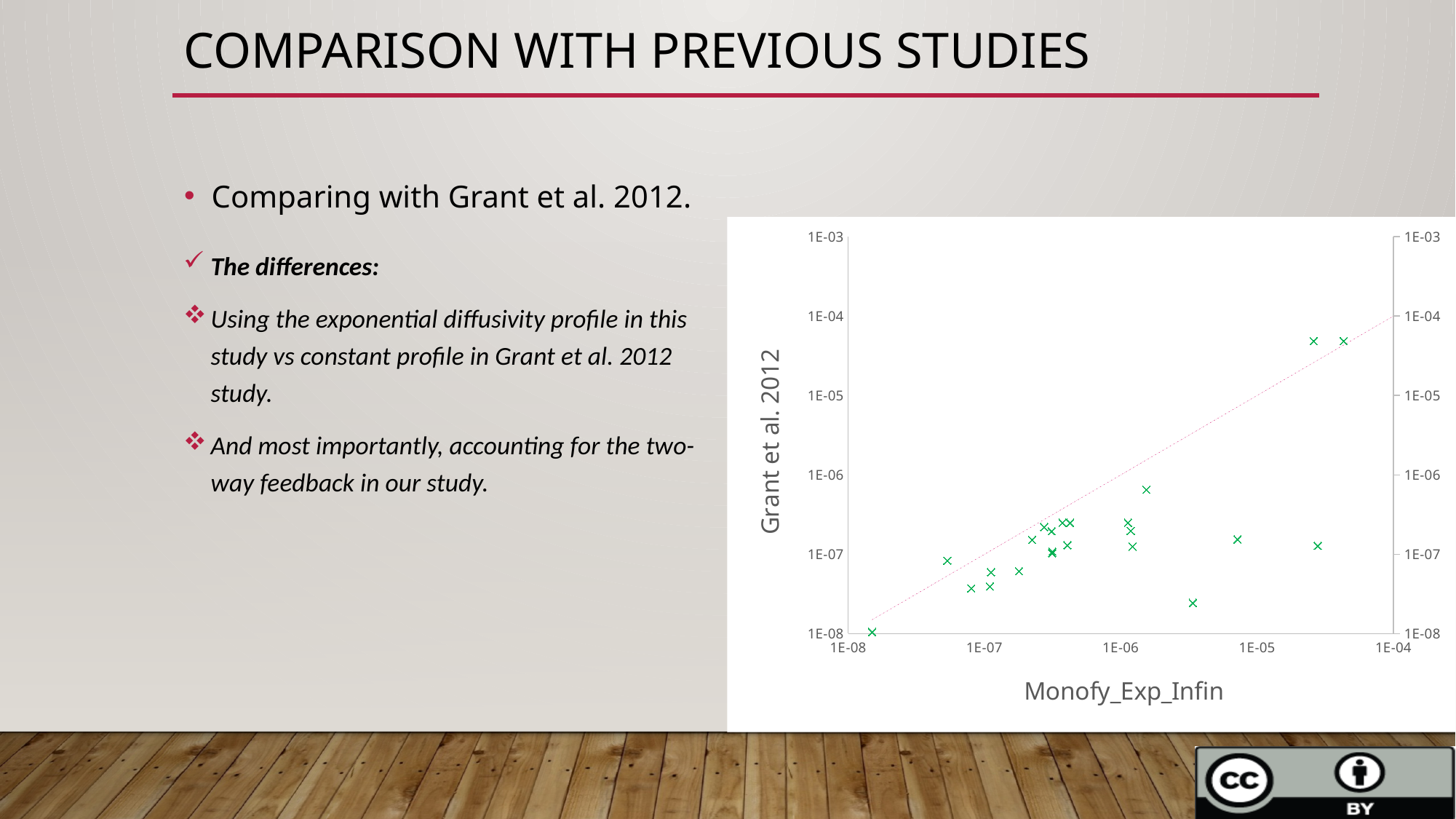
Is the highest plotted y value in the chart greater or less than 1E-05? greater Is the highest plotted y value in the chart greater or less than 1E-04? less What is the lowest tick label shown on the x axis of the chart? 1E-08 Are any points in the chart plotted above 1E-03 on the y axis? No What is the title of the x axis of the chart? Monofy_Exp_Infin What is the highest tick label shown on the y axis of the chart? 1E-03 How many tick labels are shown on the x axis of the chart? 5 What is the title of the y axis of the chart? Grant et al. 2012 What kind of chart is shown on the slide? Scatter chart Do the plotted points in the chart generally rise or fall as the x value increases? rise